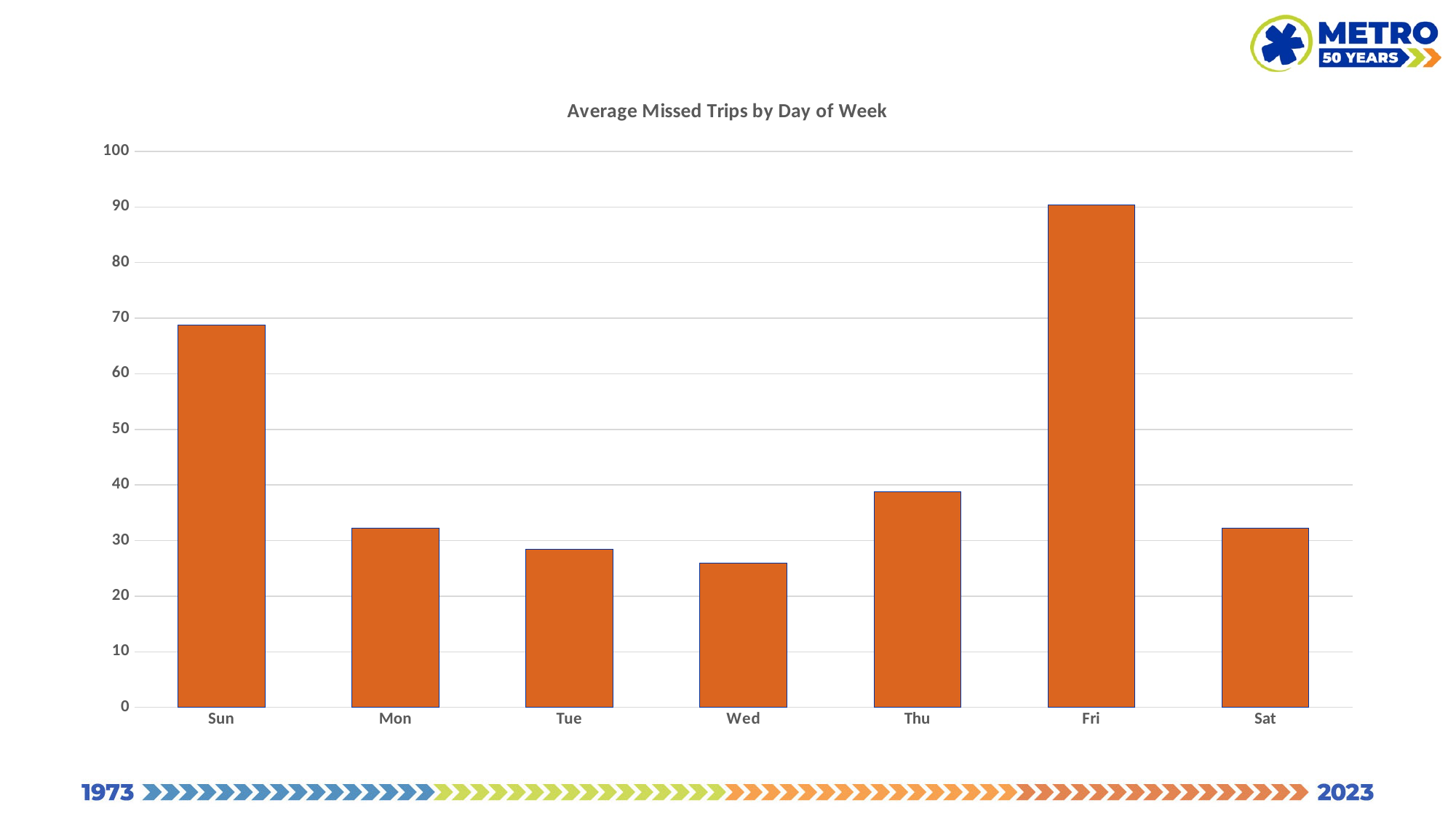
Is the value for Thu greater or less than 40? less Which day has the highest average missed trips? Fri What is the title of the chart? Average Missed Trips by Day of Week What type of chart is shown on the slide? bar chart How many days of the week are shown on the x axis? 7 Is the value for Wed greater or less than 30? less Which has more average missed trips, Sun or Thu? Sun Is the value for Sun greater or less than 70? less Which day has the lowest average missed trips? Wed Which has more average missed trips, Tue or Wed? Tue